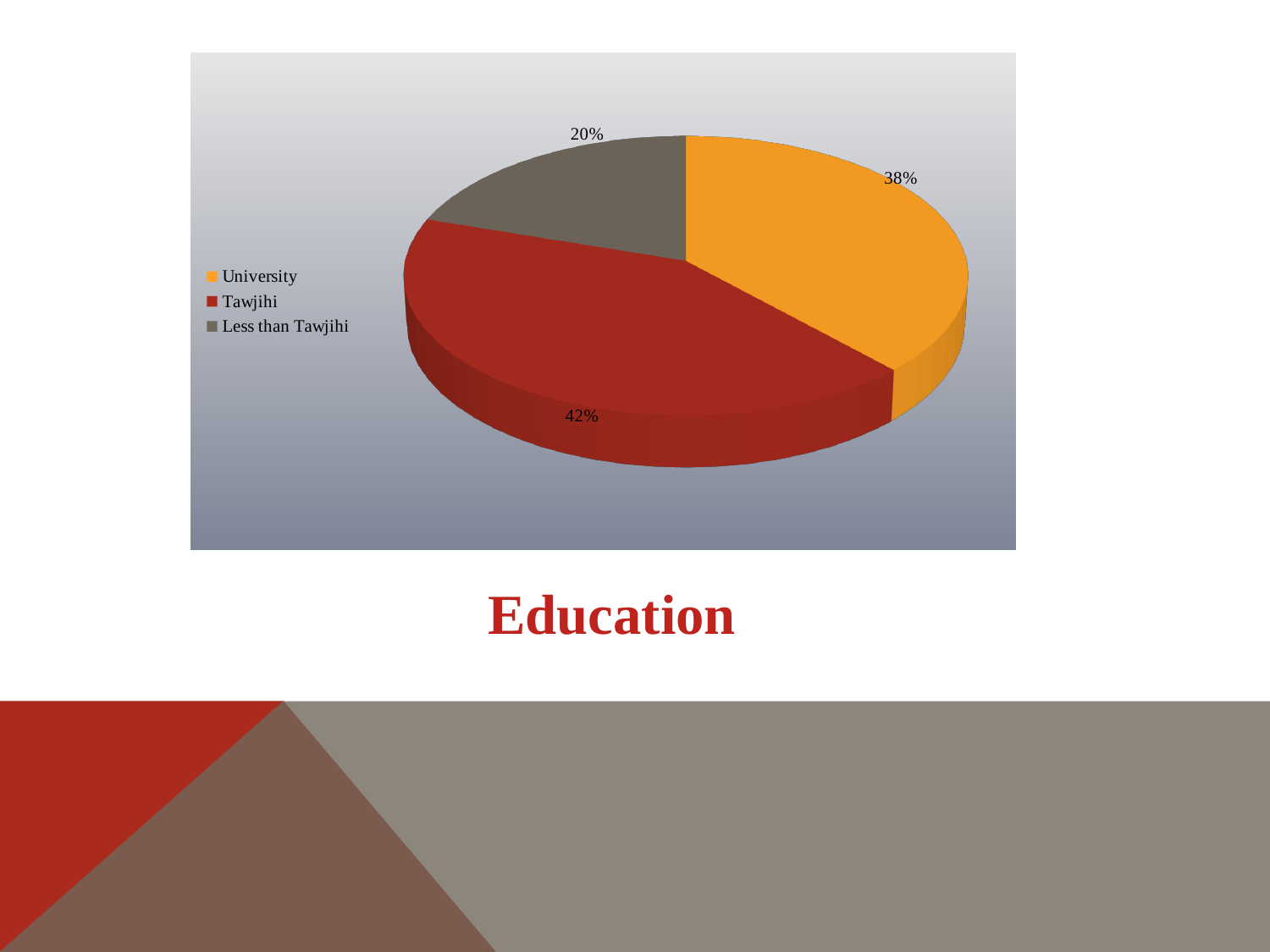
What is the title shown below the chart? Education Which category has the largest share of the pie chart? Tawjihi What colour represents Tawjihi in the pie chart? Red What percentage of the pie chart is Less than Tawjihi? 20% What percentage of the pie chart is Tawjihi? 42% What percentage of the pie chart is University? 38% What kind of chart is shown on the slide? Pie chart What is the difference in percentage points between University and Less than Tawjihi? 18 Which category has the smallest share of the pie chart? Less than Tawjihi Which is larger, the share for University or the share for Less than Tawjihi? University What is the difference in percentage points between Tawjihi and University? 4 How many categories are shown in the pie chart? 3